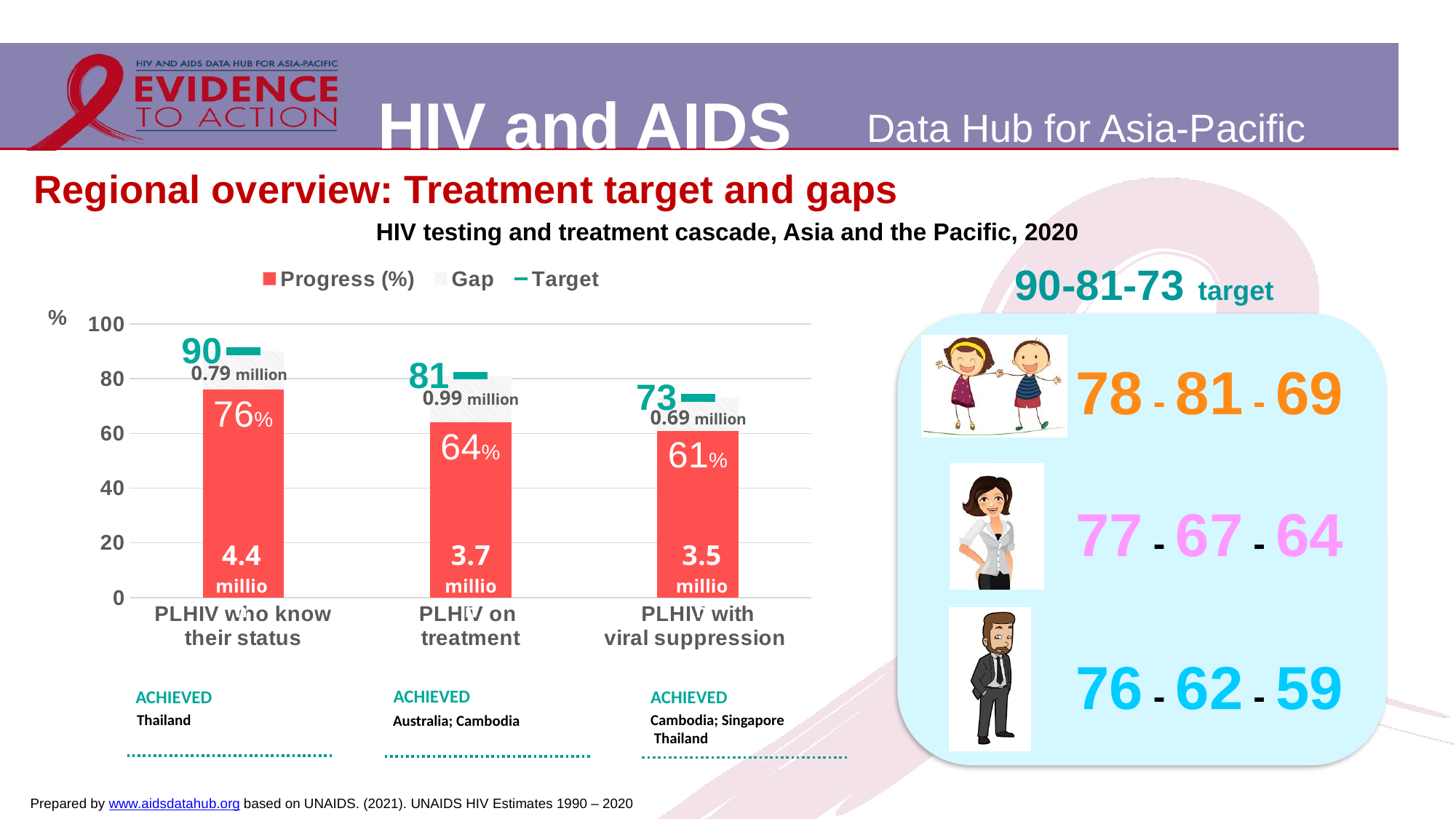
Which category has the lowest progress percentage? PLHIV with viral suppression How many series does the chart legend list? 3 Which is larger: the gap for PLHIV who know their status or the gap for PLHIV on treatment? PLHIV on treatment What is the target value shown for PLHIV on treatment? 81 What is the progress percentage for PLHIV with viral suppression? 61% What is the progress percentage for PLHIV who know their status? 76% What type of chart is used to show the HIV testing and treatment cascade? Bar chart Which category has the highest progress percentage? PLHIV who know their status What is the gap shown for PLHIV on treatment? 0.99 million How many categories are shown on the x axis of the chart? 3 What is the difference in progress percentage between PLHIV who know their status and PLHIV with viral suppression? 15 percentage points What is the progress percentage for PLHIV on treatment? 64%